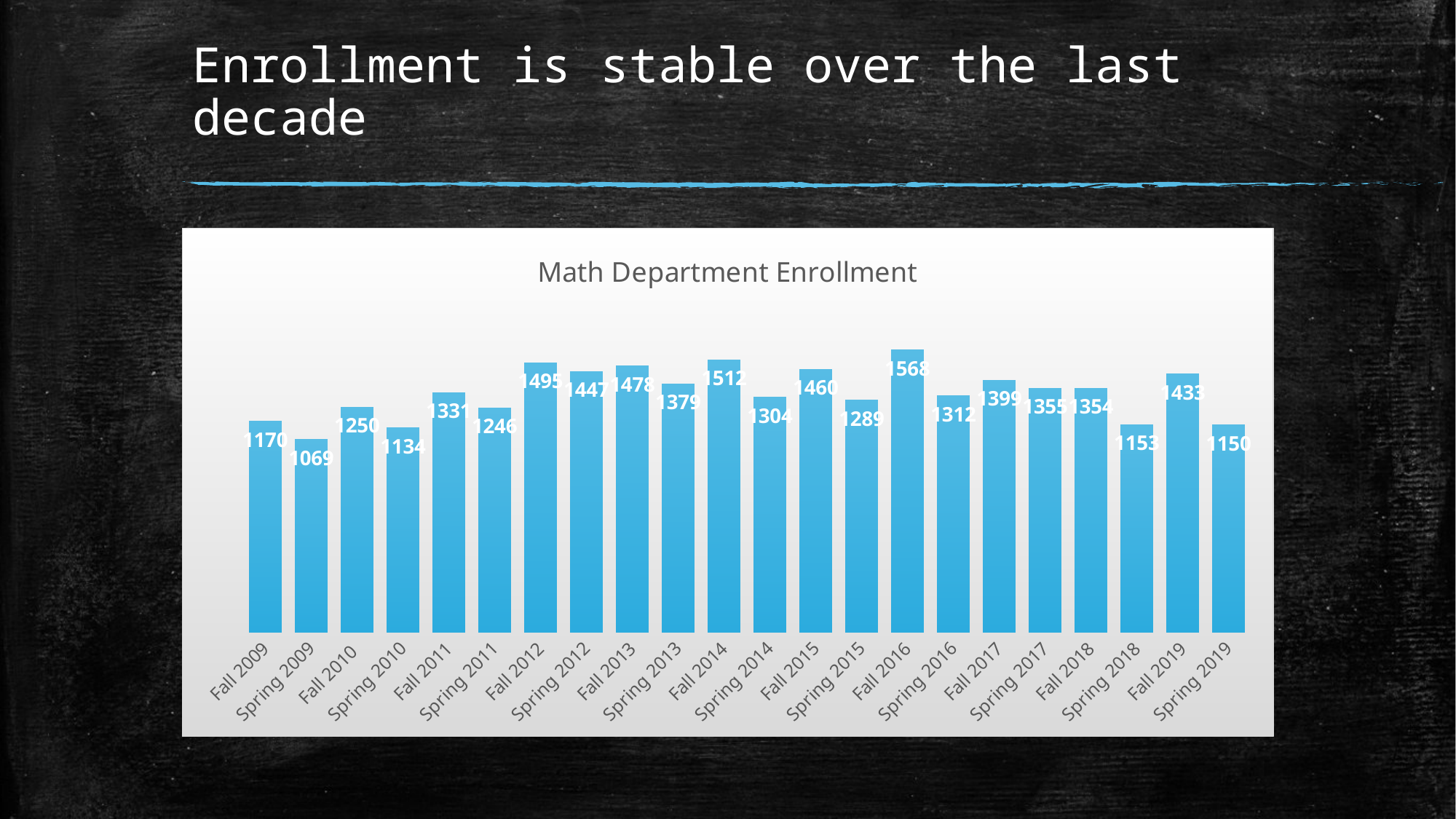
What is the enrollment value for Fall 2016? 1568 What kind of chart is shown on the slide? Bar chart How many semesters are shown on the chart? 22 Which semester has the highest enrollment? Fall 2016 What is the enrollment value for Spring 2009? 1069 What is the enrollment value for Spring 2014? 1304 What is the title of the chart? Math Department Enrollment What is the difference between the enrollment in Fall 2016 and Spring 2009? 499 Which is larger, the enrollment in Fall 2014 or Spring 2014? Fall 2014 Which semester has the lowest enrollment? Spring 2009 What is the difference between the enrollment in Fall 2019 and Spring 2019? 283 What is the enrollment value for Fall 2019? 1433